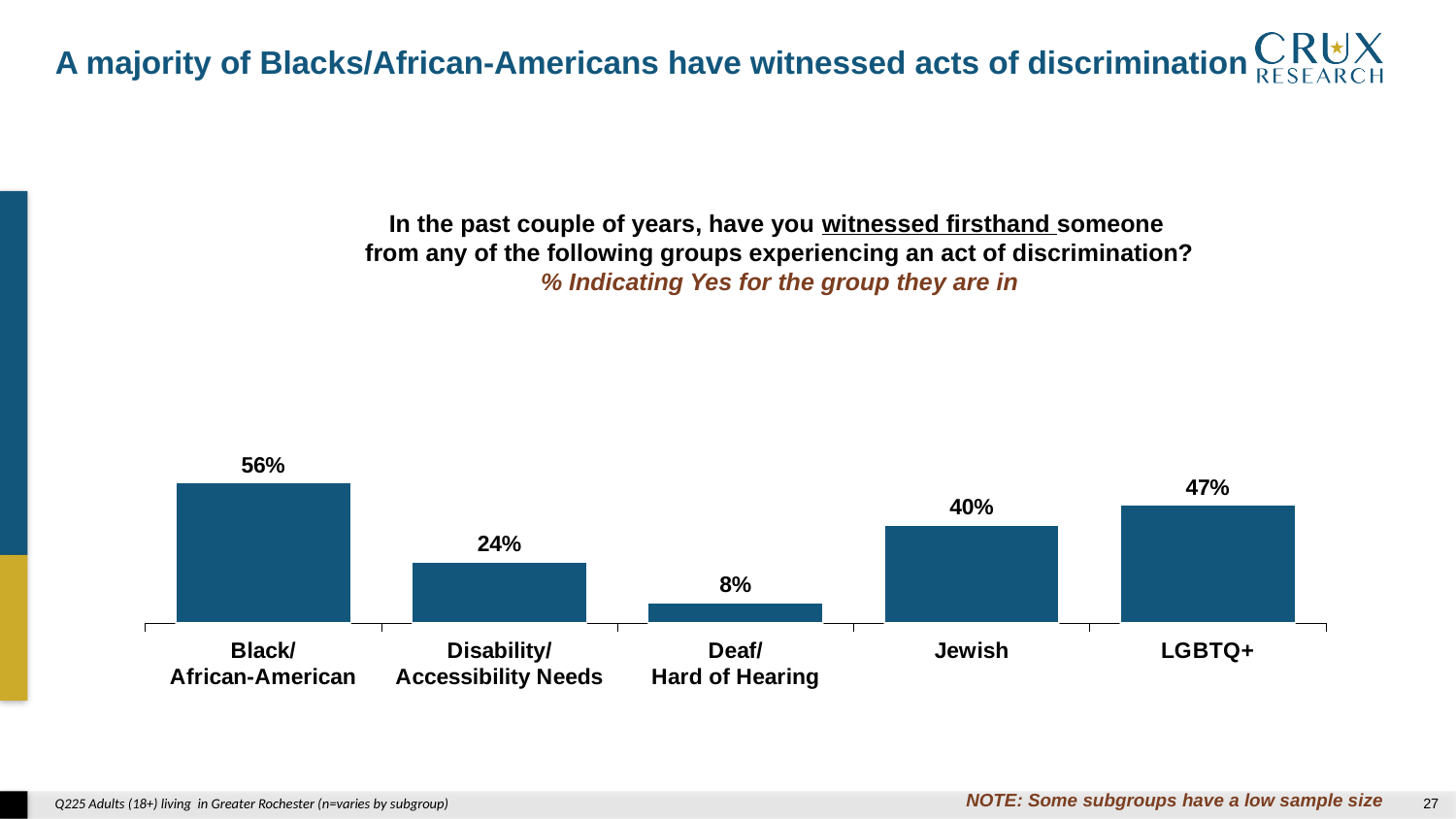
Which group has the highest percentage indicating Yes? Black/African-American What kind of chart is shown on the slide? Bar chart What percentage of Black/African-American respondents indicated they witnessed firsthand an act of discrimination? 56% What is the difference between the Black/African-American value and the LGBTQ+ value? 9% How many groups are shown in the chart? 5 What percentage is shown for the Deaf/Hard of Hearing group? 8% Which group has the lowest percentage indicating Yes? Deaf/Hard of Hearing What is the value for the LGBTQ+ group? 47% What colour are the bars in the chart? Dark blue What is the value shown for the Jewish group? 40% What is the difference between the Disability/Accessibility Needs value and the Deaf/Hard of Hearing value? 16% Which is larger, the value for Jewish or the value for Disability/Accessibility Needs? Jewish